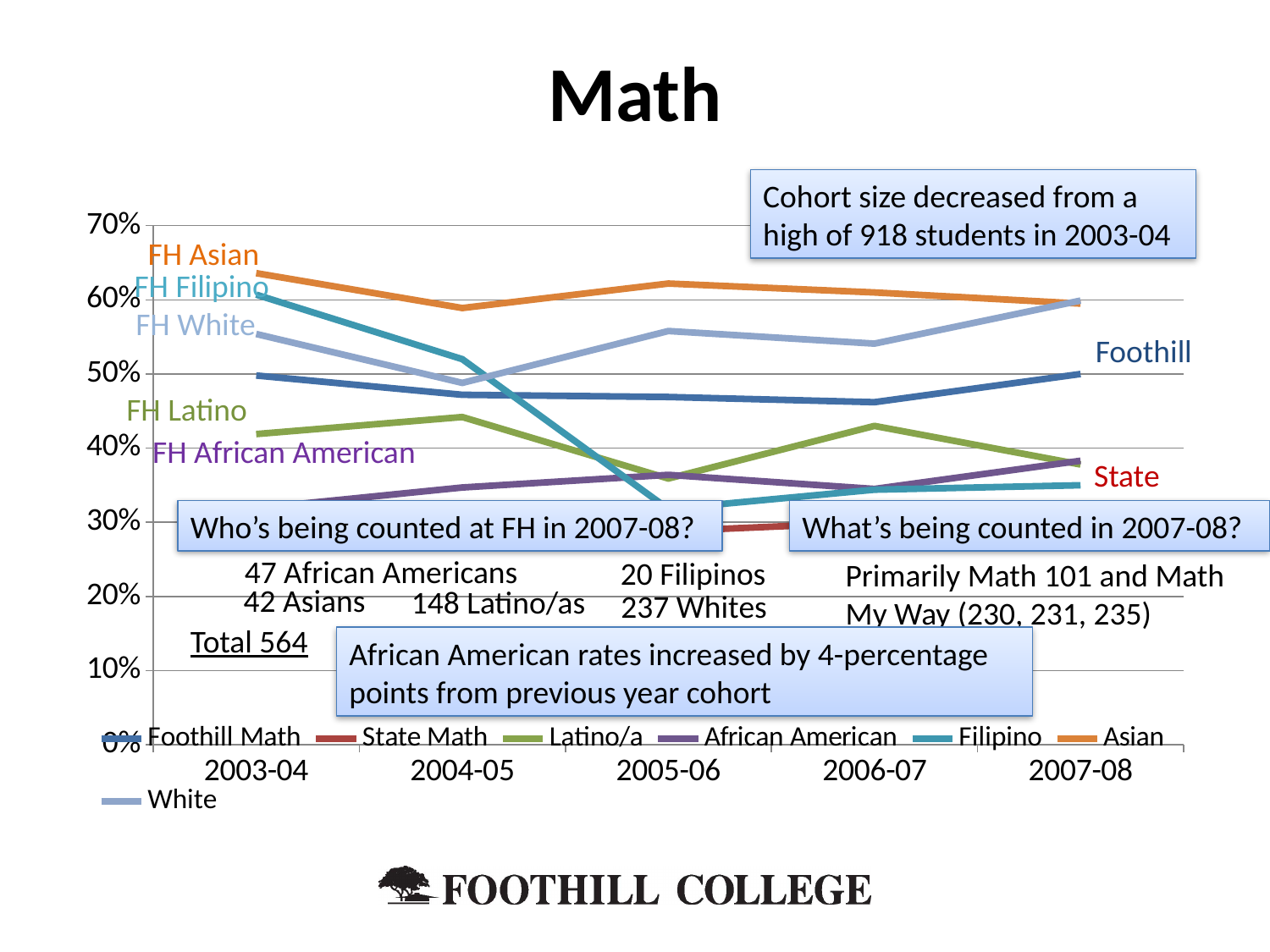
Which is larger in 2006-07, Latino/a or African American? Latino/a Is the value for Latino/a in 2004-05 greater or less than 40%? greater How many academic years are shown on the x axis? 5 Is the value for Filipino in 2006-07 greater or less than 40%? less Is the value for Foothill Math in 2006-07 greater or less than 50%? less Does the Filipino series rise or fall from 2003-04 to 2005-06? fall What is the title of the slide's chart? Math Which series has the highest value in 2004-05? Asian Which is larger in 2007-08, White or Foothill Math? White How many series does the legend list? 7 What kind of chart is shown on the slide? line chart